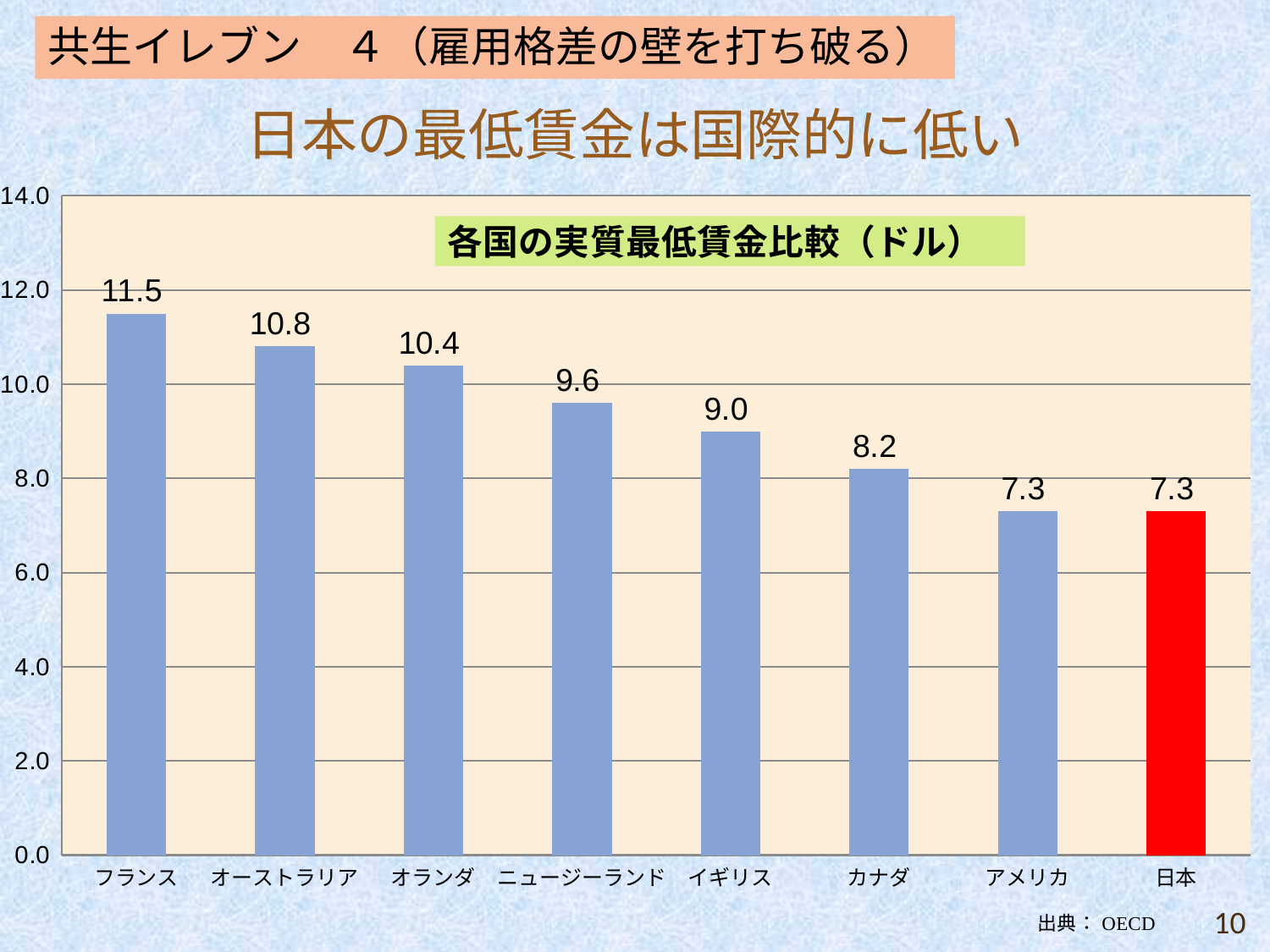
Do the values rise or fall from left to right along the x axis? fall What is the title of the chart? 各国の実質最低賃金比較（ドル） How many countries are shown in the chart? 8 What is the difference between the values for フランス and 日本? 4.2 What kind of chart is shown on the slide? bar chart What is the value for カナダ? 8.2 Which country's bar is coloured red? 日本 What is the value for 日本? 7.3 Which country has the highest value? フランス Is the value for ニュージーランド greater or less than 10.0? less What is the value for フランス? 11.5 Which is larger, the value for オランダ or the value for イギリス? オランダ